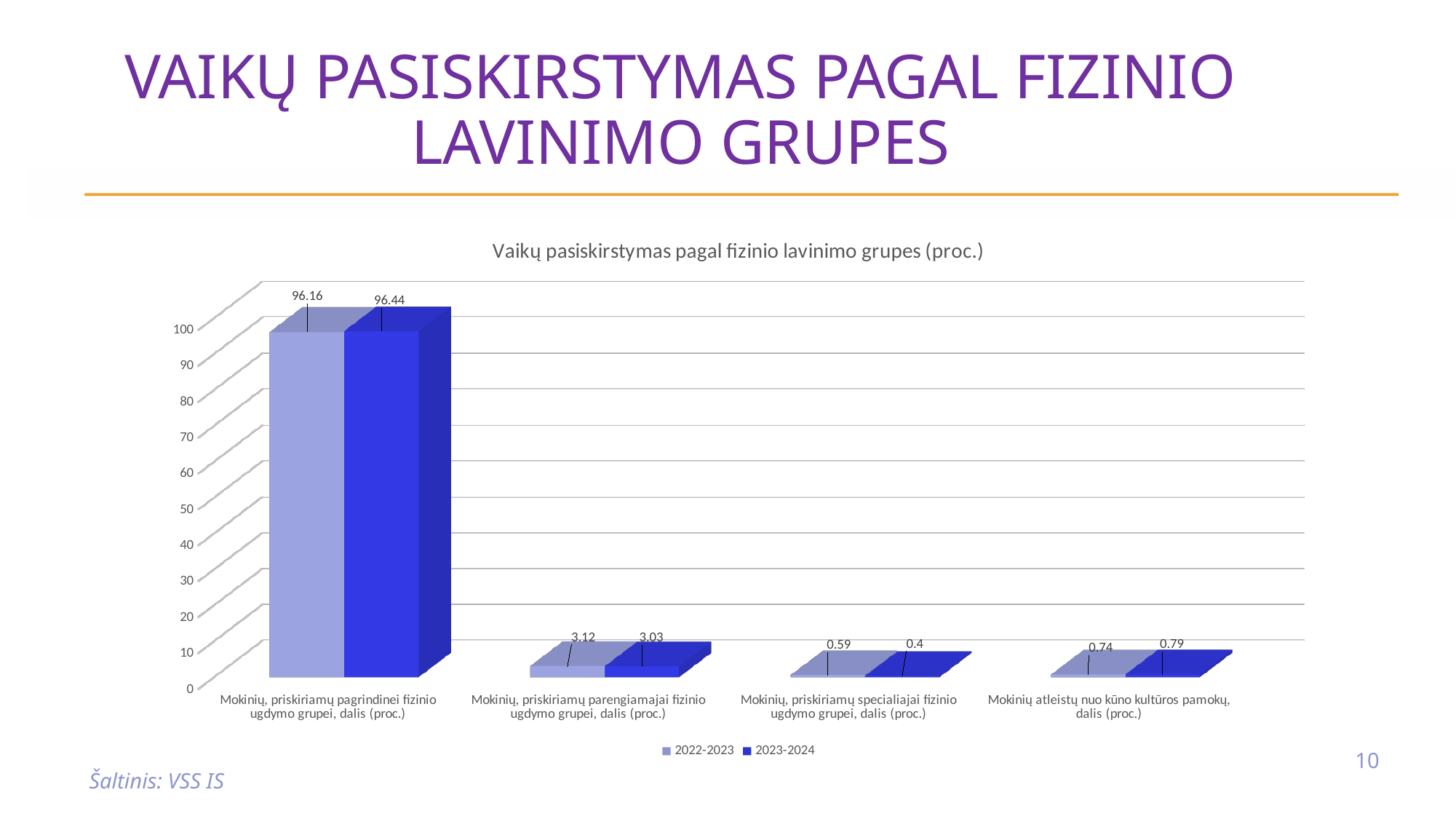
What is the value for 2023-2024 in the category "Mokinių, priskiriamų pagrindinei fizinio ugdymo grupei, dalis (proc.)"? 96.44 What is the value for 2023-2024 in the category "Mokinių, priskiriamų specialiajai fizinio ugdymo grupei, dalis (proc.)"? 0.4 Which category has the highest value for 2022-2023? Mokinių, priskiriamų pagrindinei fizinio ugdymo grupei, dalis (proc.) What kind of chart is shown on the slide? Bar chart What is the value for 2022-2023 in the category "Mokinių, priskiriamų parengiamajai fizinio ugdymo grupei, dalis (proc.)"? 3.12 For "Mokinių, priskiriamų parengiamajai fizinio ugdymo grupei, dalis (proc.)", which series has the larger value, 2022-2023 or 2023-2024? 2022-2023 How many categories are shown on the x axis of the chart? 4 What is the value for 2022-2023 in the category "Mokinių atleistų nuo kūno kultūros pamokų, dalis (proc.)"? 0.74 How many series does the chart legend list? 2 What is the difference between the 2023-2024 and 2022-2023 values for "Mokinių, priskiriamų pagrindinei fizinio ugdymo grupei, dalis (proc.)"? 0.28 Which category has the lowest value for 2023-2024? Mokinių, priskiriamų specialiajai fizinio ugdymo grupei, dalis (proc.) Is the 2022-2023 value for "Mokinių, priskiriamų pagrindinei fizinio ugdymo grupei, dalis (proc.)" greater or less than 90? greater